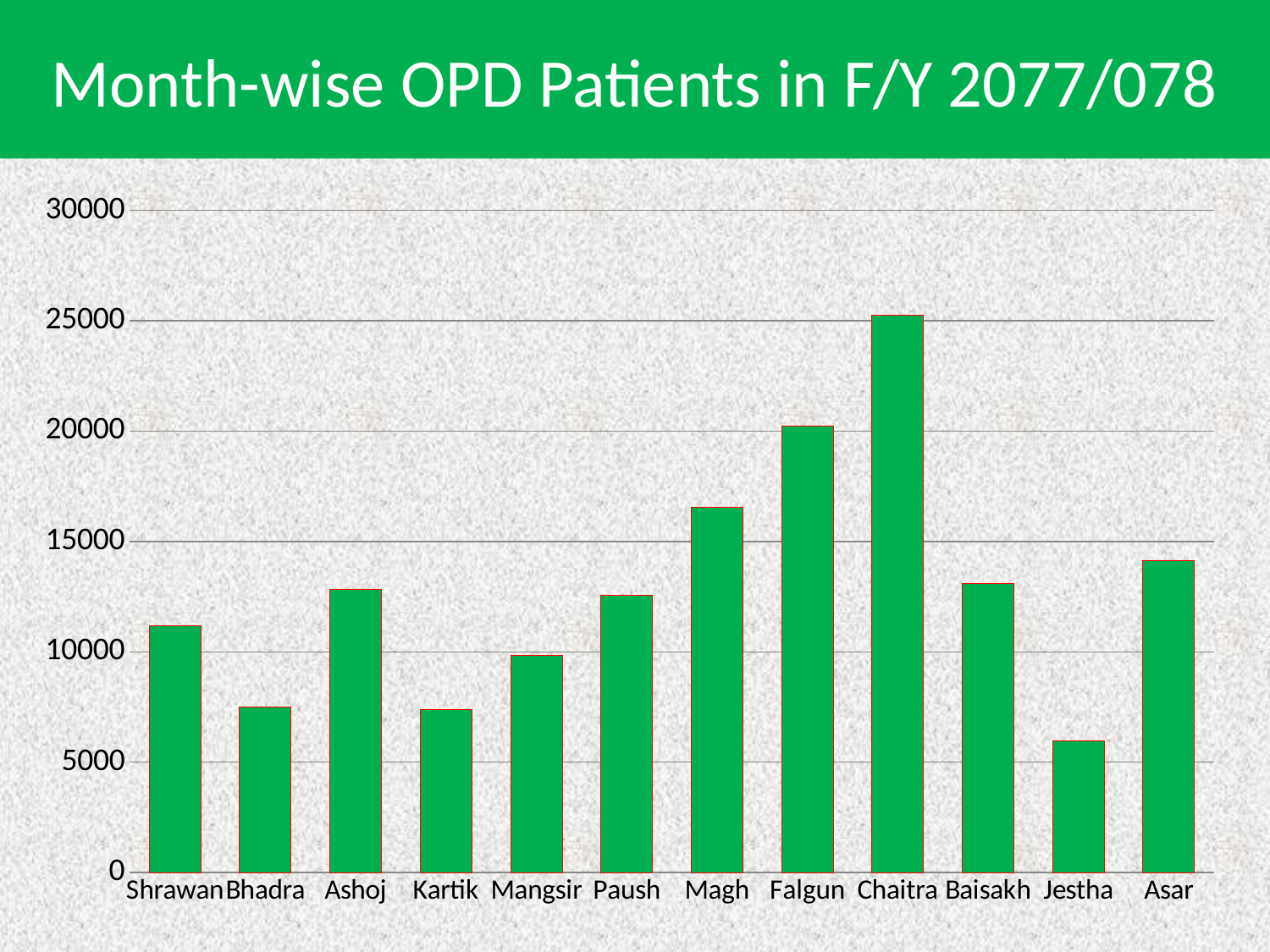
Do the values rise or fall from Kartik to Chaitra? rise What is the title of the chart? Month-wise OPD Patients in F/Y 2077/078 Which month has more OPD patients, Asar or Baisakh? Asar Is the value for Chaitra greater or less than 20000? greater Which month has more OPD patients, Falgun or Magh? Falgun Is the value for Magh greater or less than 15000? greater How many months are shown on the x axis? 12 What kind of chart is shown on the slide? bar chart Which month has the highest number of OPD patients? Chaitra Which month has the lowest number of OPD patients? Jestha Is the value for Asar greater or less than 15000? less